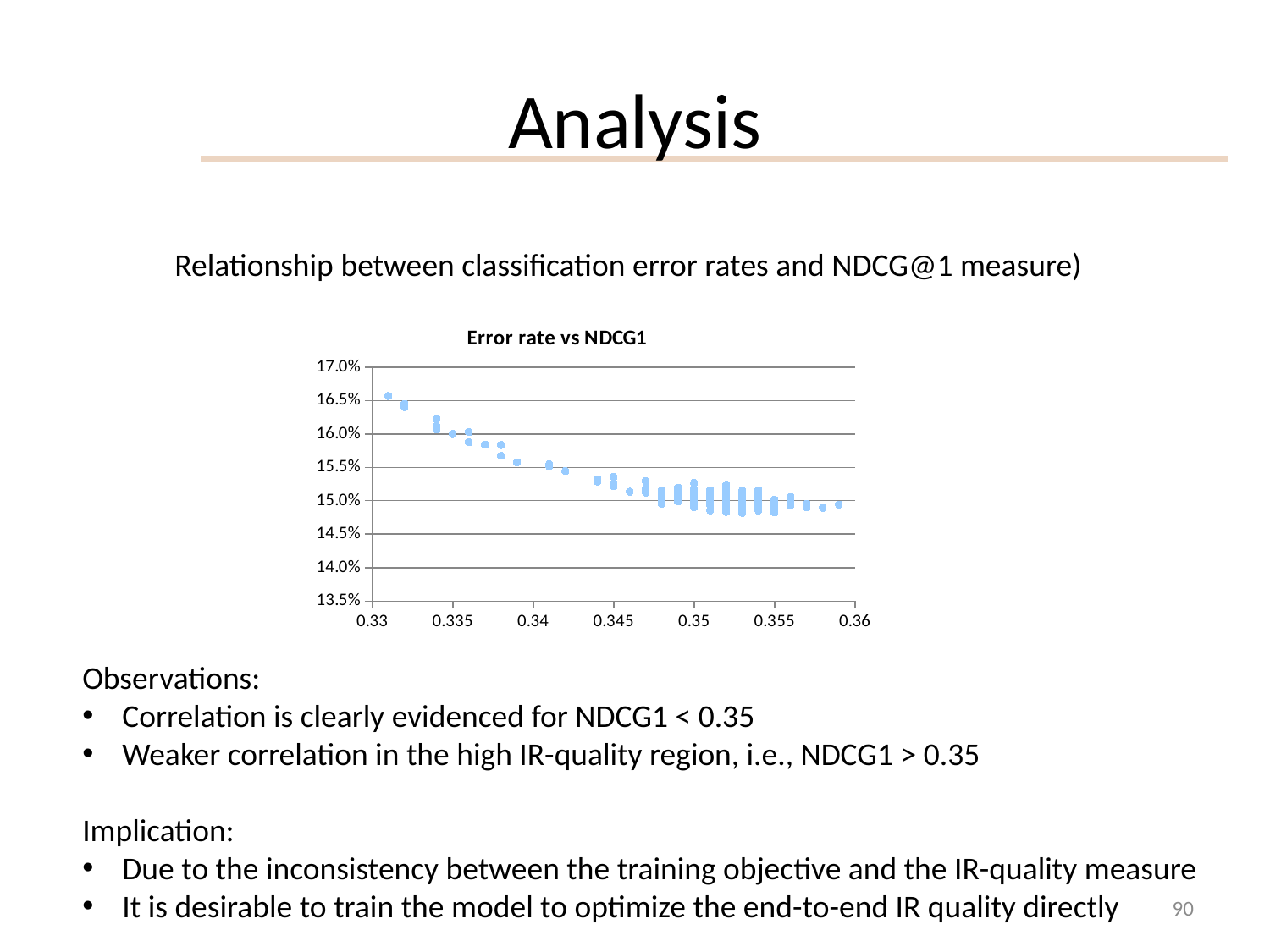
Is the error rate for the rightmost point (near NDCG1 0.359) greater or less than 15.5%? less Are the error rate values plotted near NDCG1 0.345 greater or less than 15.5%? less Are the error rate values plotted near NDCG1 0.345 greater or less than 15.0%? greater Which end of the x axis has the higher error rates, the 0.33 end or the 0.36 end? The 0.33 end Do the error rate values rise or fall as NDCG1 increases along the x axis? Fall What is the highest value shown on the y axis of the chart? 17.0% What kind of chart is shown on the slide? Scatter chart What is the title of the chart? Error rate vs NDCG1